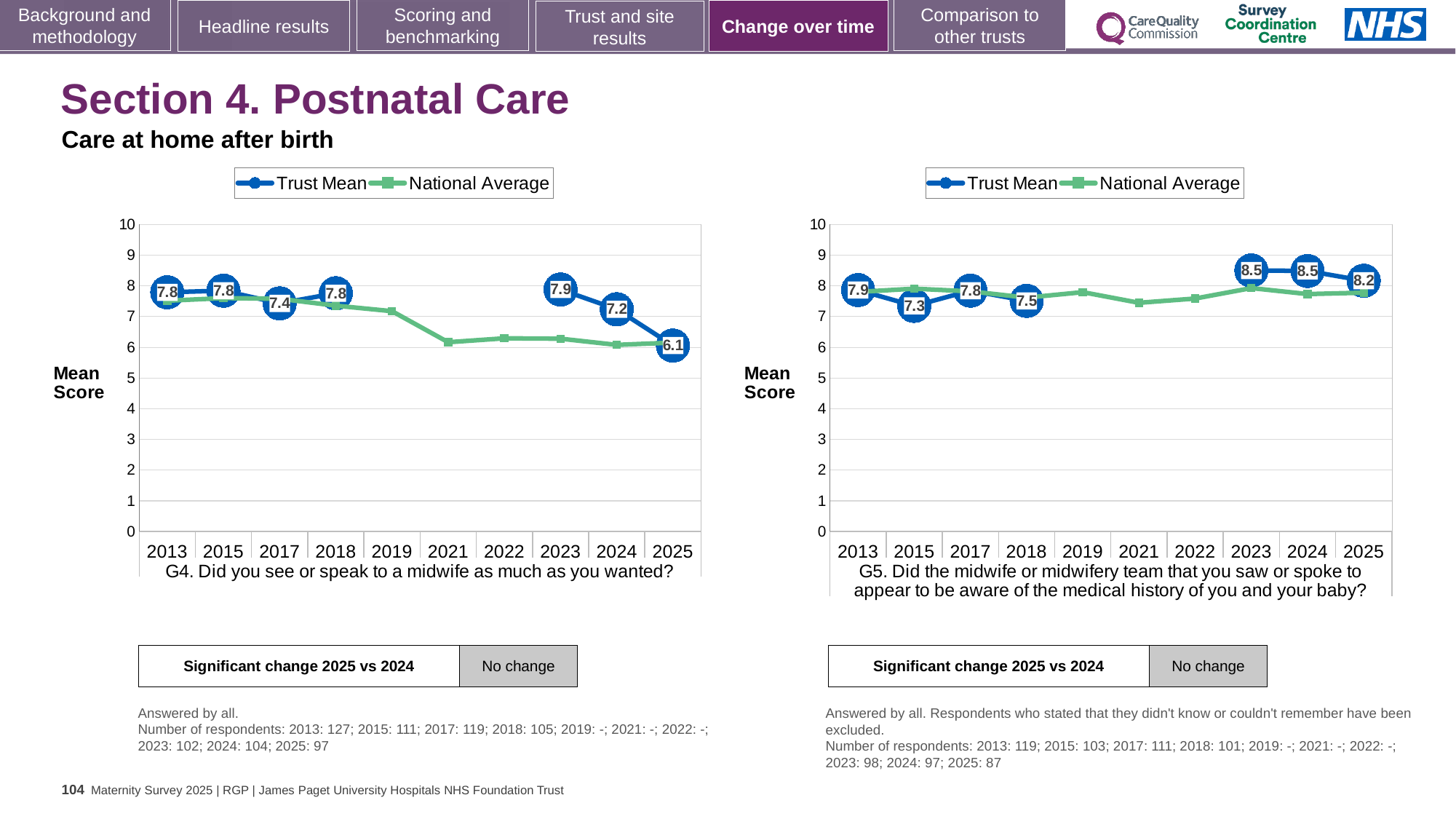
How many series does the legend of the G4 chart (left) list? 2 In the G4 chart (left), is the National Average for 2025 greater or less than 7? less In the G5 chart (right), is the Trust Mean for 2023 larger or smaller than the Trust Mean for 2018? larger In the G4 chart (left), what is the difference between the Trust Mean for 2024 and 2025? 1.1 In the G5 chart (right), what is the Trust Mean for 2025? 8.2 What type of chart is the G5 chart (right)? line chart In the G5 chart (right), which year has the lowest Trust Mean? 2015 In the G5 chart (right), what is the Trust Mean for 2015? 7.3 In the G4 chart (left), which year has the lowest Trust Mean? 2025 How many years are shown on the x axis of the G5 chart (right)? 10 In the G4 chart (left), what is the Trust Mean for 2017? 7.4 In the G4 chart (left), what is the Trust Mean for 2025? 6.1